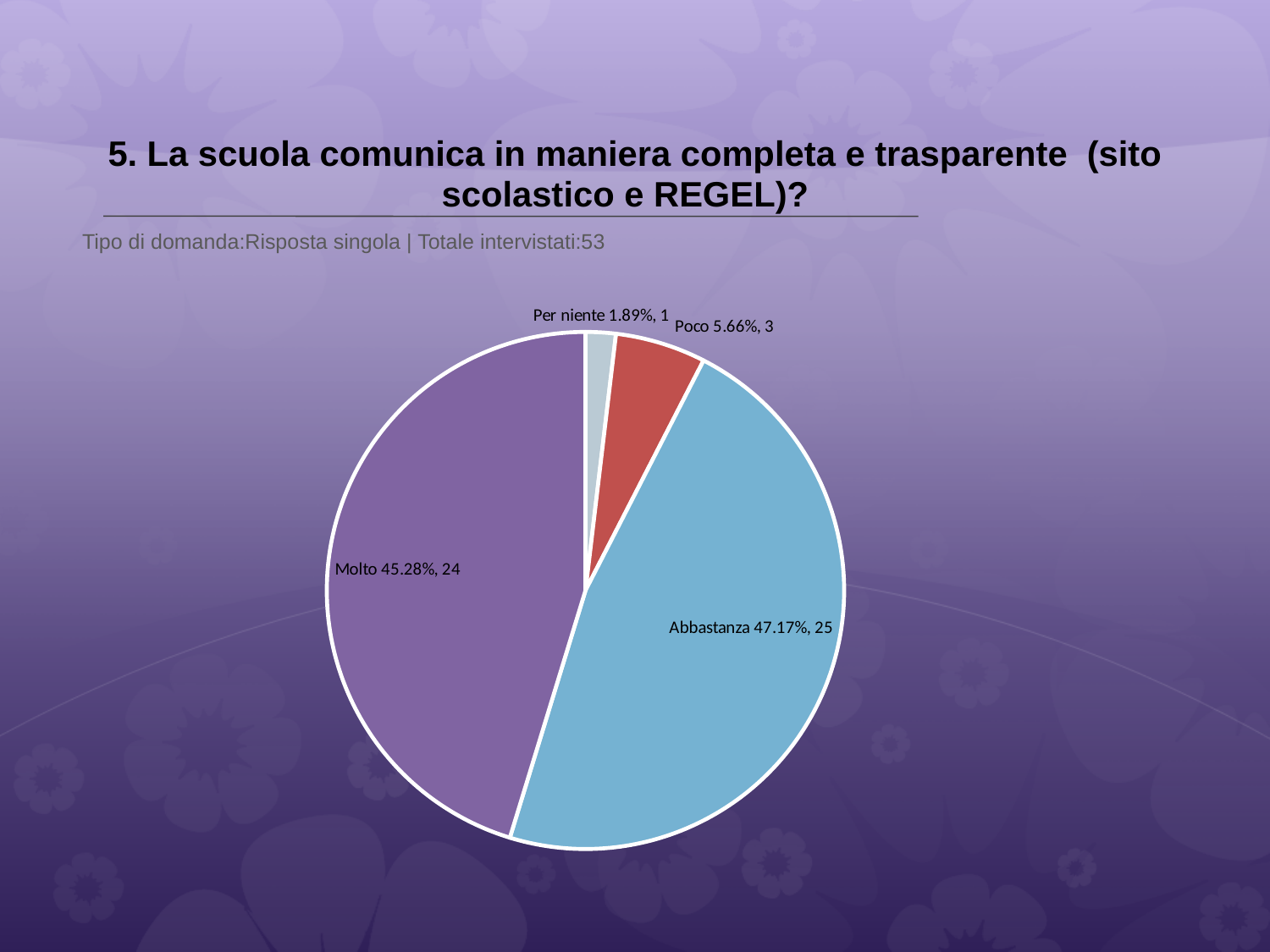
What kind of chart is shown on the slide? pie chart How many respondents answered "Poco"? 3 What colour is the "Abbastanza" slice? blue What is the total number of respondents shown in the subtitle (Totale intervistati)? 53 How many respondents answered "Per niente"? 1 Which category has the smallest slice of the pie? Per niente Which category has the largest slice of the pie? Abbastanza What percentage share does the "Molto" slice have? 45.28% What is the difference in respondent count between "Abbastanza" and "Molto"? 1 How many slices does the pie chart have? 4 Which has more respondents, "Poco" or "Per niente"? Poco What percentage share does the "Abbastanza" slice have? 47.17%